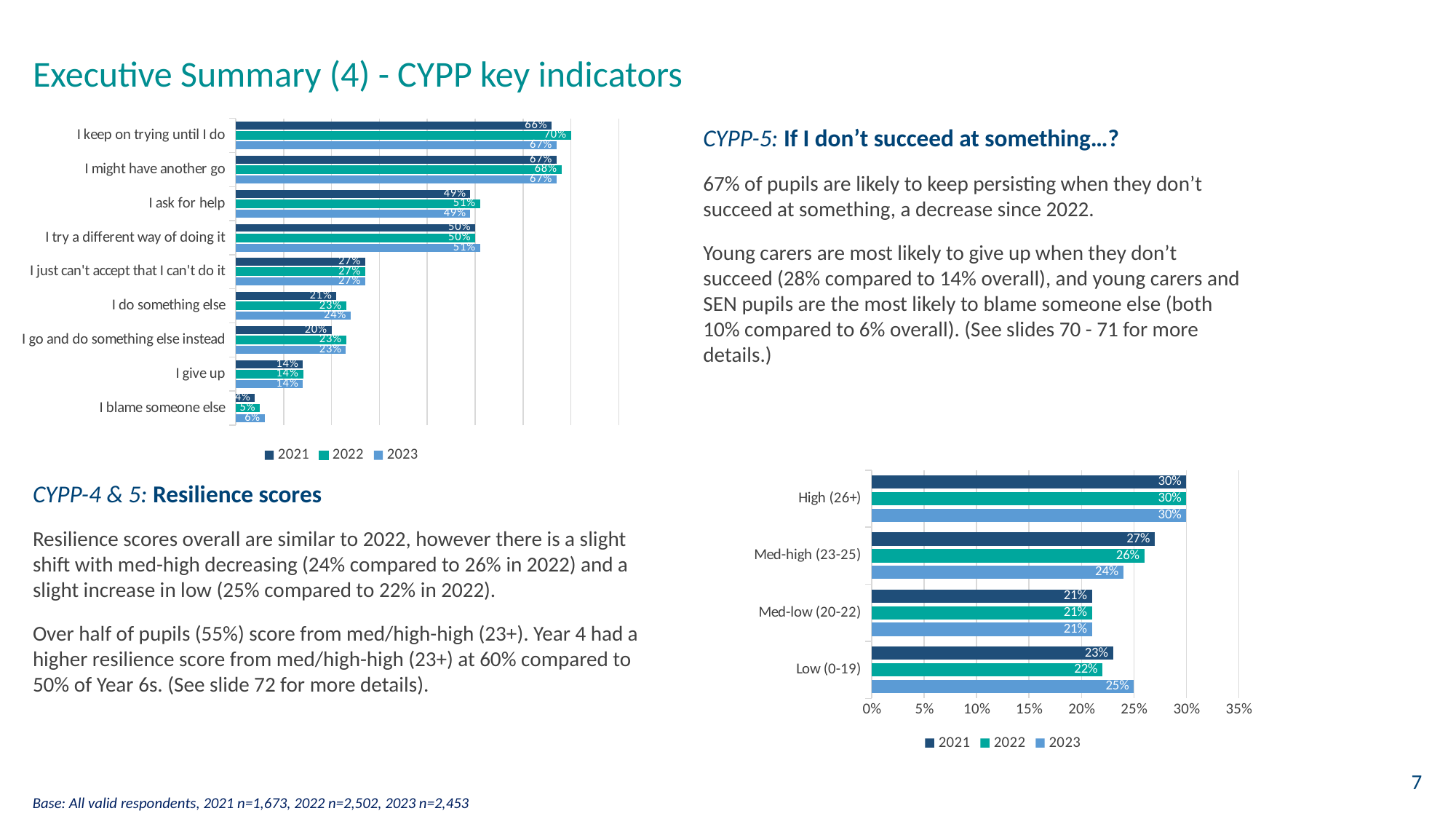
In the top-left chart, what is the difference between the 2021 and 2023 values for 'I do something else'? 3% How many categories are shown in the top-left chart? 9 In the bottom-right chart, which category has the highest 2023 value? High (26+) In the top-left chart, which category has the lowest values across all three years? I blame someone else In the bottom-right chart, what is the 2021 value for Med-high (23-25)? 27% How many series does the legend of the bottom-right chart list? 3 In the bottom-right chart, what is the difference between the 2021 and 2023 values for Med-high (23-25)? 3% In the top-left chart, what is the 2022 value for 'I keep on trying until I do'? 70% What type of chart is the bottom-right chart? Bar chart In the bottom-right chart, what is the 2023 value for Low (0-19)? 25% In the top-left chart, what is the 2023 value for 'I give up'? 14% In the bottom-right chart, which is larger for Low (0-19): the 2022 value or the 2023 value? 2023